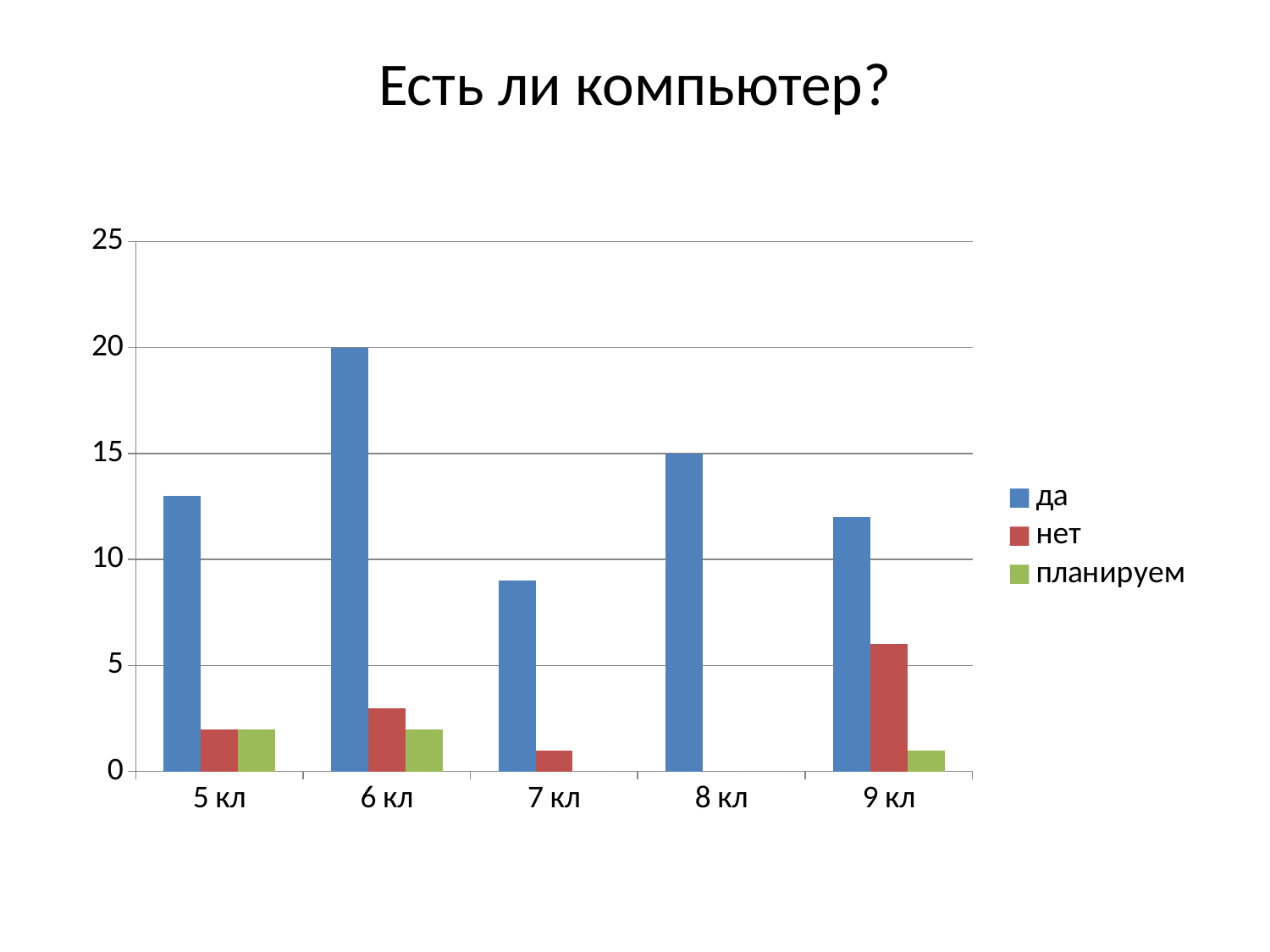
How many series does the legend list? 3 Is the "да" value for 5 кл greater or less than 10? greater Is the "да" value for 7 кл greater or less than 10? less Which class has the highest value for the "да" series? 6 кл What is the value of the "да" series for 8 кл? 15 What is the value of the "да" series for 6 кл? 20 Is the "нет" value for 9 кл greater or less than 5? greater Which is larger: the "да" value for 5 кл or for 7 кл? 5 кл Which class has the highest value for the "нет" series? 9 кл How many classes are shown on the x axis? 5 What type of chart is shown on the slide? Bar chart Which class has the lowest value for the "да" series? 7 кл